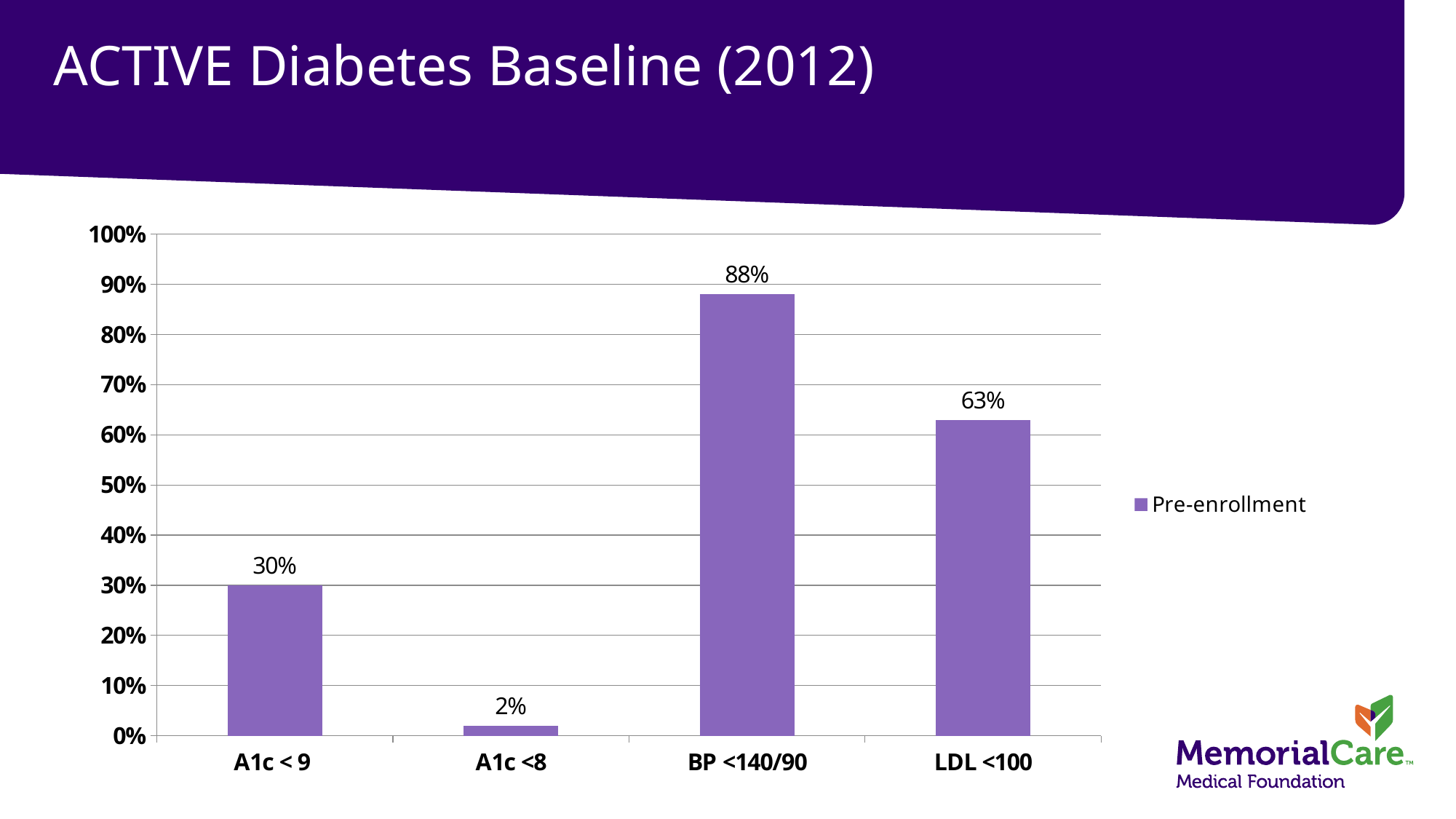
What kind of chart is shown on the slide? Bar chart Which category has the lowest value? A1c <8 What is the Pre-enrollment value for LDL <100? 63% Which category has the highest value? BP <140/90 Which is larger, the value for LDL <100 or the value for A1c < 9? LDL <100 What is the difference between the values for BP <140/90 and LDL <100? 25% What is the difference between the values for A1c < 9 and A1c <8? 28% How many series does the legend list? 1 What is the Pre-enrollment value for A1c <8? 2% How many categories are shown on the x axis? 4 What is the Pre-enrollment value for BP <140/90? 88% What is the Pre-enrollment value for A1c < 9? 30%